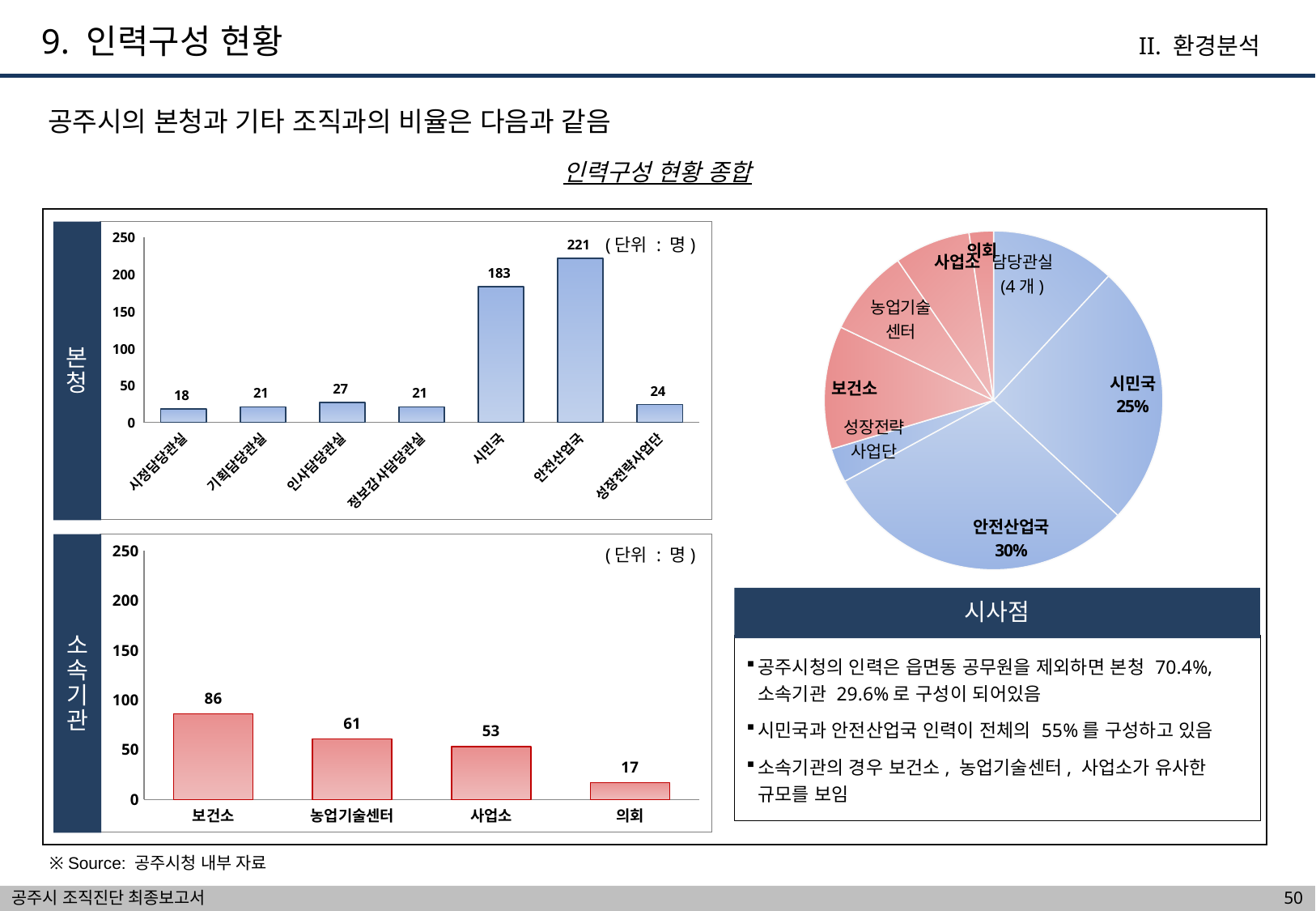
In the 본청 bar chart, what is the value for 시민국? 183 In the 본청 bar chart, what is the difference between 안전산업국 and 시민국? 38 In the 본청 bar chart, which category has the lowest value? 시정담당관실 In the 소속기관 bar chart, what is the value for 보건소? 86 In the 소속기관 bar chart, which category has the highest value? 보건소 In the 소속기관 bar chart, is the value for 의회 greater or less than 50? less In the pie chart on the right, what share does 안전산업국 have? 30% In the 소속기관 bar chart, which is larger, 농업기술센터 or 의회? 농업기술센터 In the 본청 bar chart, how many categories are shown? 7 In the 본청 bar chart, what is the value for 안전산업국? 221 What kind of chart is shown on the right side of the slide? pie chart In the 소속기관 bar chart, what is the difference between 농업기술센터 and 사업소? 8